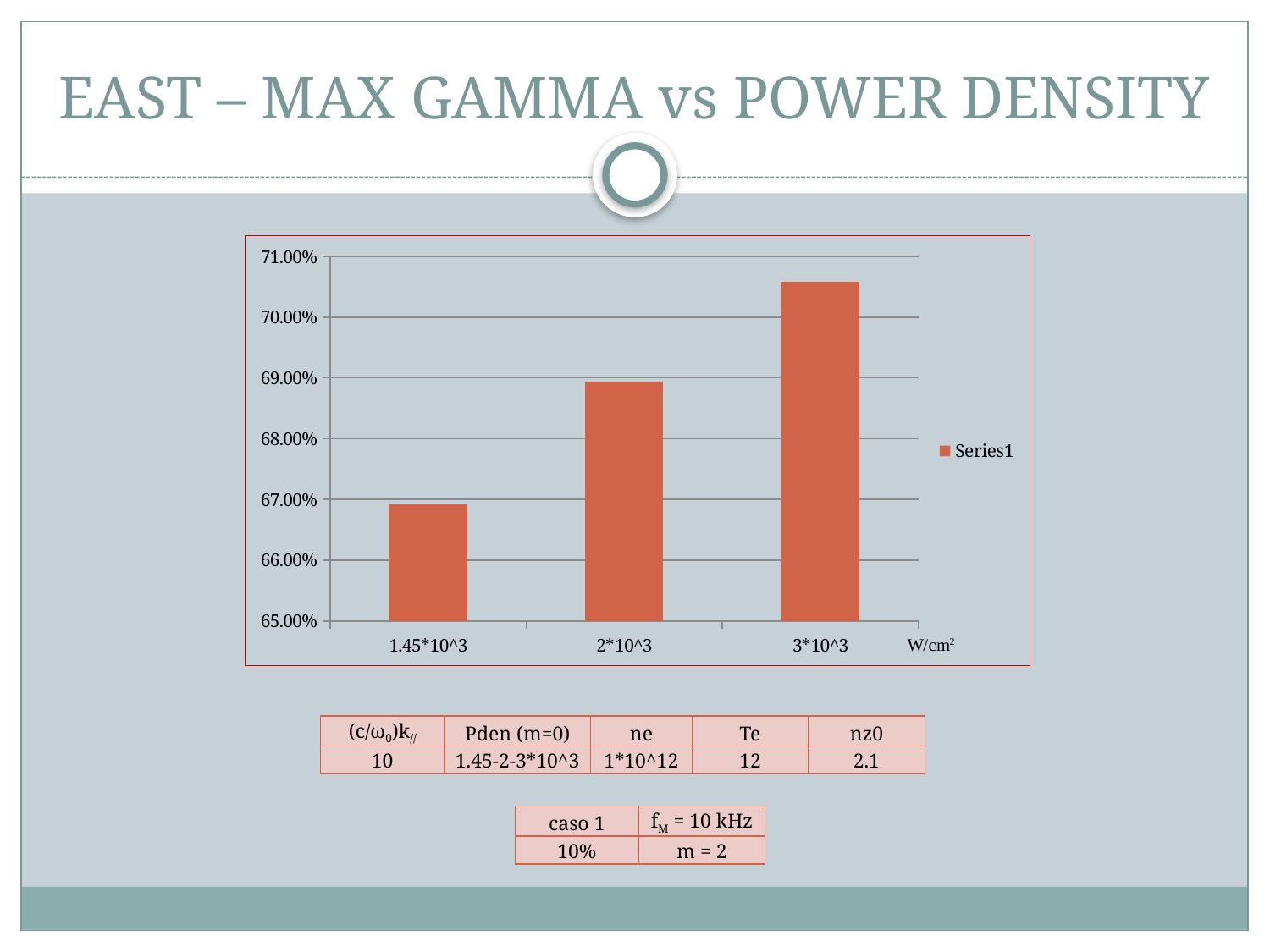
Is the value for 1.45*10^3 greater or less than 68.00%? less Which power density category has the highest bar? 3*10^3 What unit is printed at the end of the x axis of the chart? W/cm² How many series does the chart legend list? 1 Which is larger, the value for 2*10^3 or the value for 1.45*10^3? 2*10^3 Is the value for 3*10^3 greater or less than 70.00%? greater Which power density category has the lowest bar? 1.45*10^3 What is the name of the series shown in the chart legend? Series1 Do the bar values rise or fall as power density increases along the x axis? rise What kind of chart is shown on the slide? bar chart How many bars (categories) are plotted in the chart? 3 Is the value for 2*10^3 greater or less than 68.00%? greater